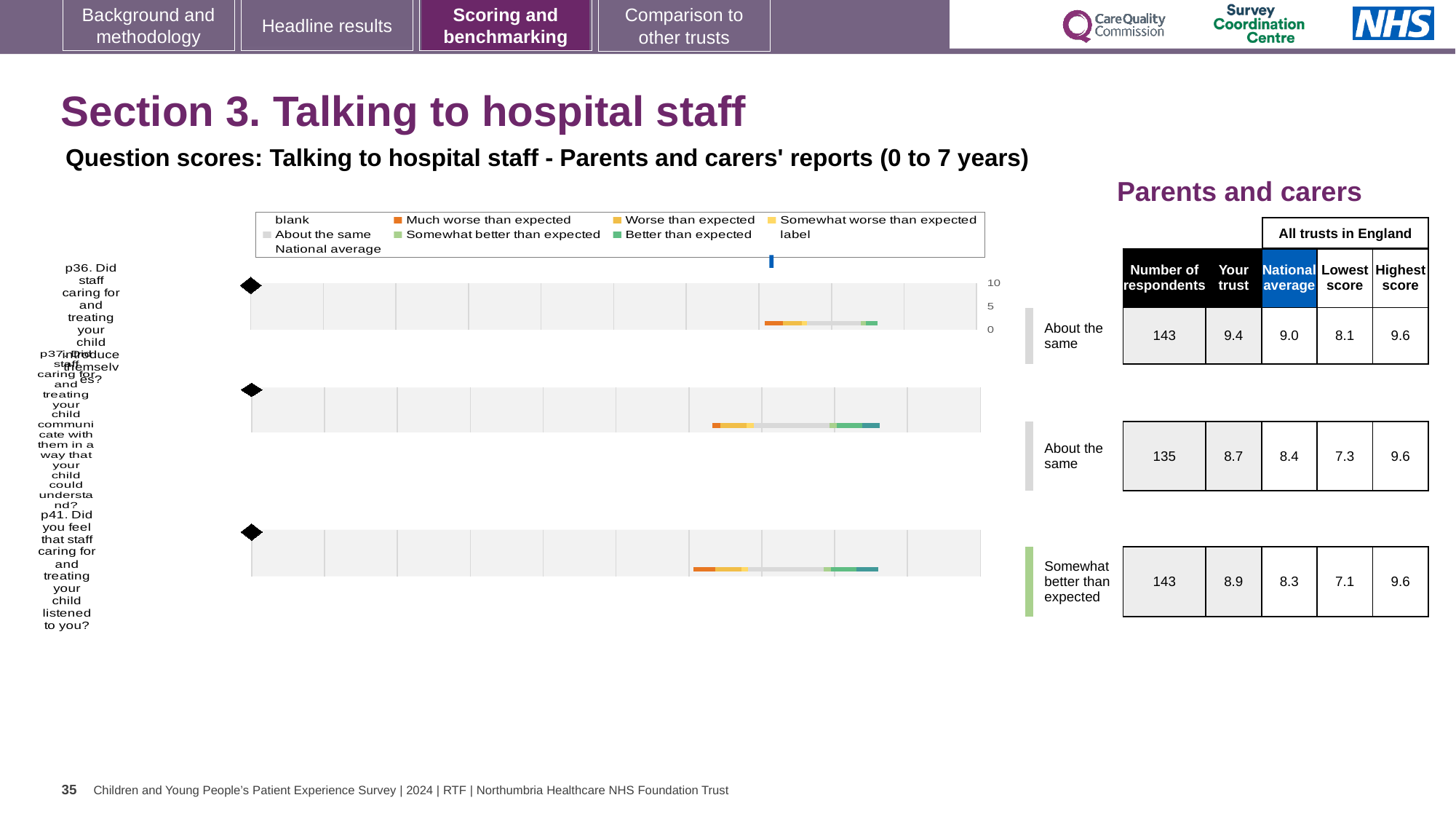
What benchmark category is p41 placed in? Somewhat better than expected What is the lowest score across all trusts in England for p41 (Did you feel that staff listened to you?)? 7.1 What is the national average for p37 (Did staff communicate with your child in a way they could understand?)? 8.4 Which of the three questions has the lowest national average? p41 How many questions (p36, p37, p41) are plotted on the slide? 3 Which of the three questions has the highest 'Your trust' score? p36 Is the 'Your trust' score for p36 higher or lower than the national average for p36? higher What is the 'Your trust' score for p36 (Did staff caring for and treating your child introduce themselves?)? 9.4 What kind of chart is used to show the question scores on this slide? bar chart What is the highest score across all trusts in England for p36? 9.6 What is the difference between the 'Your trust' score and the national average for p41? 0.6 How many respondents answered p37? 135